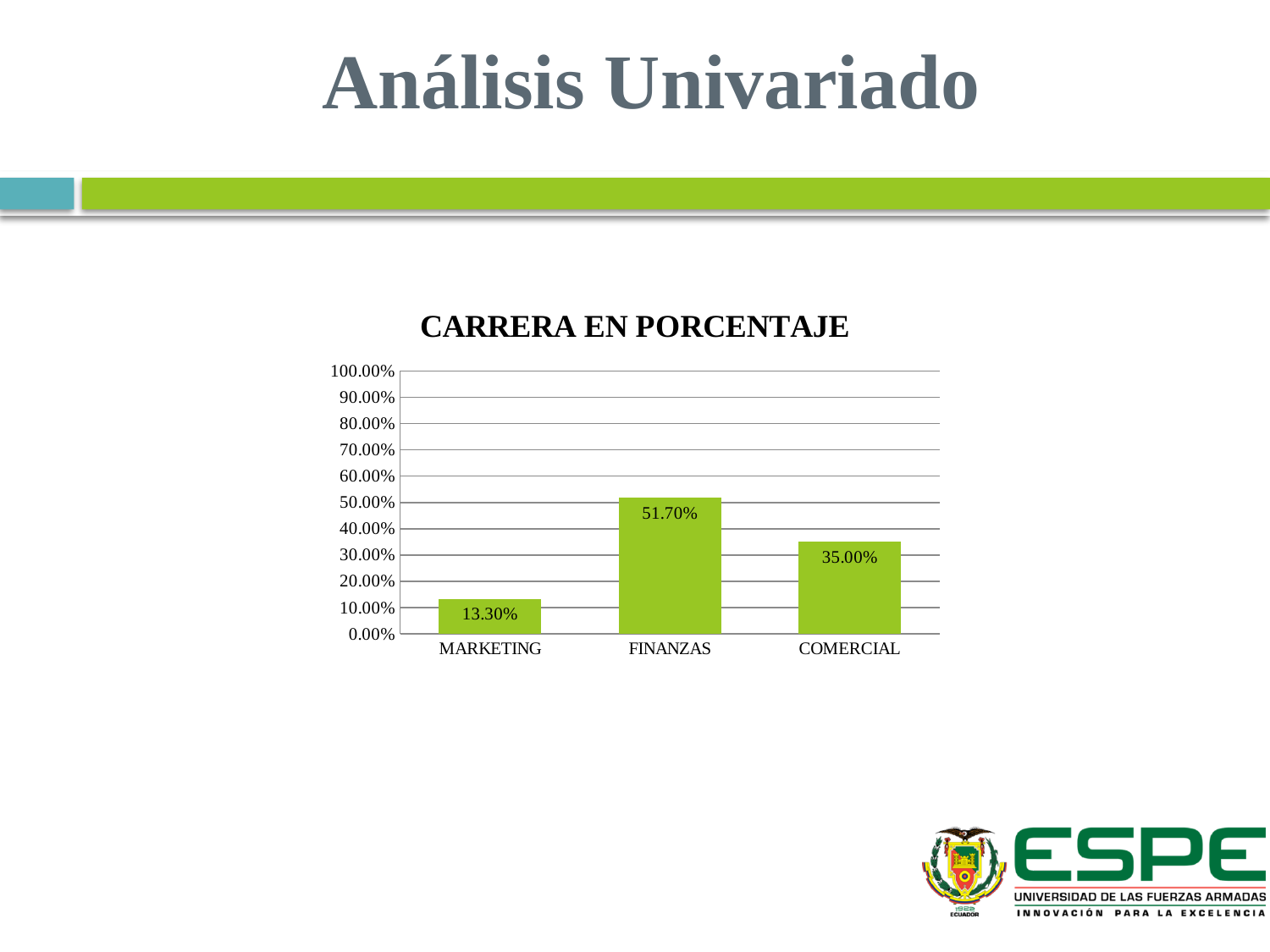
Is the value for FINANZAS greater or less than 50.00%? greater Which category has the highest value? FINANZAS What kind of chart is shown on the slide? bar chart What is the difference between the values for FINANZAS and COMERCIAL? 16.70% Which is larger, the value for COMERCIAL or the value for MARKETING? COMERCIAL Which category has the lowest value? MARKETING What is the value for COMERCIAL? 35.00% What is the title of the chart? CARRERA EN PORCENTAJE How many categories are shown on the x axis? 3 What is the difference between the values for COMERCIAL and MARKETING? 21.70% What is the value for FINANZAS? 51.70% What is the value for MARKETING? 13.30%